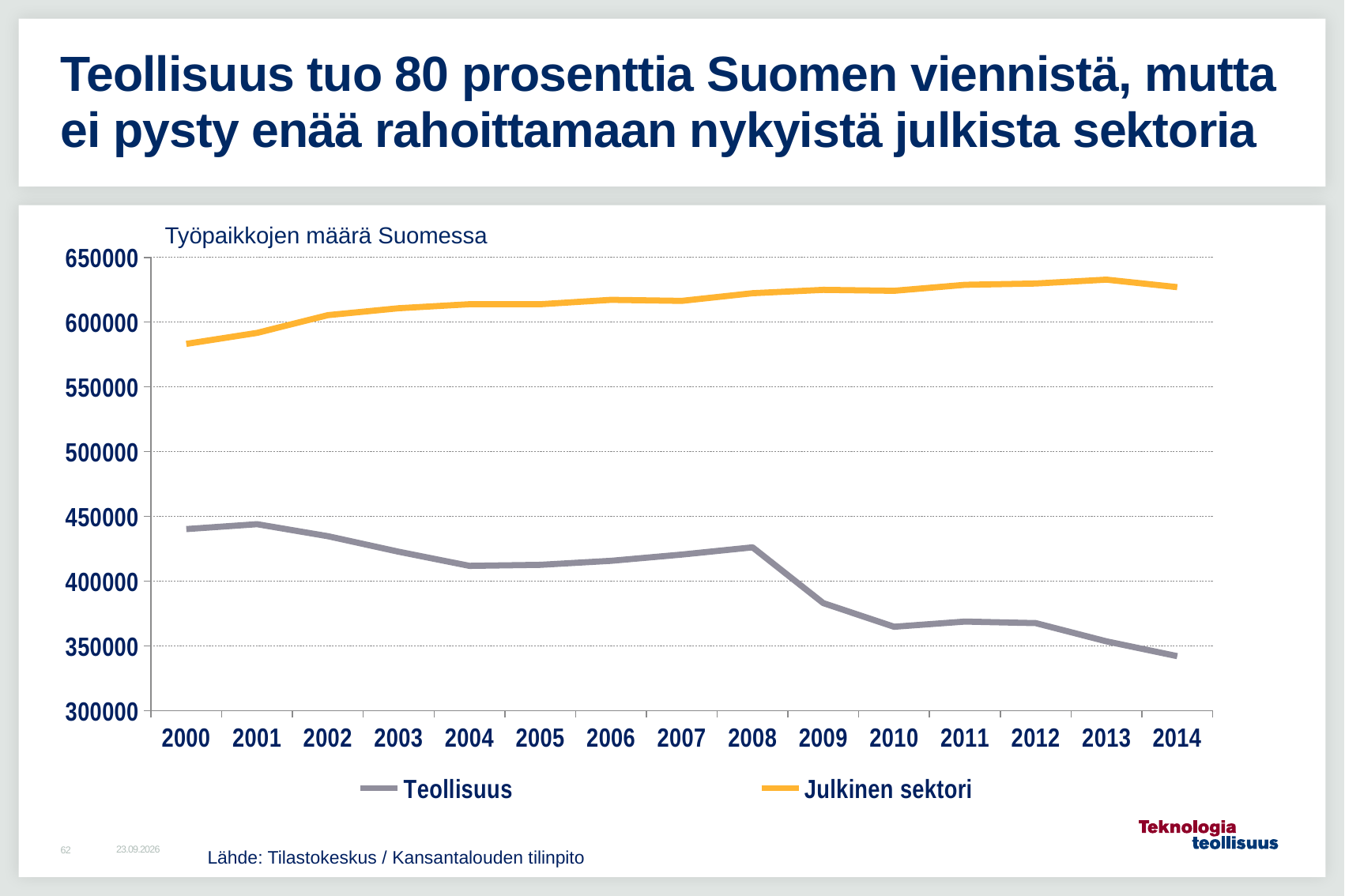
What is the title of the chart? Työpaikkojen määrä Suomessa What kind of chart is shown on the slide? line chart Does the Julkinen sektori line rise or fall overall from 2000 to 2014? rise In which year is the Teollisuus value lowest? 2014 Which series is drawn in yellow? Julkinen sektori Is the value for Julkinen sektori in 2000 greater or less than 600000? less How many series does the legend list? 2 In which year is the Julkinen sektori value highest? 2013 Is the value for Teollisuus in 2008 greater or less than 400000? greater Does the Teollisuus line rise or fall overall from 2000 to 2014? fall Is the value for Teollisuus in 2014 greater or less than 350000? less How many years are plotted along the x axis? 15